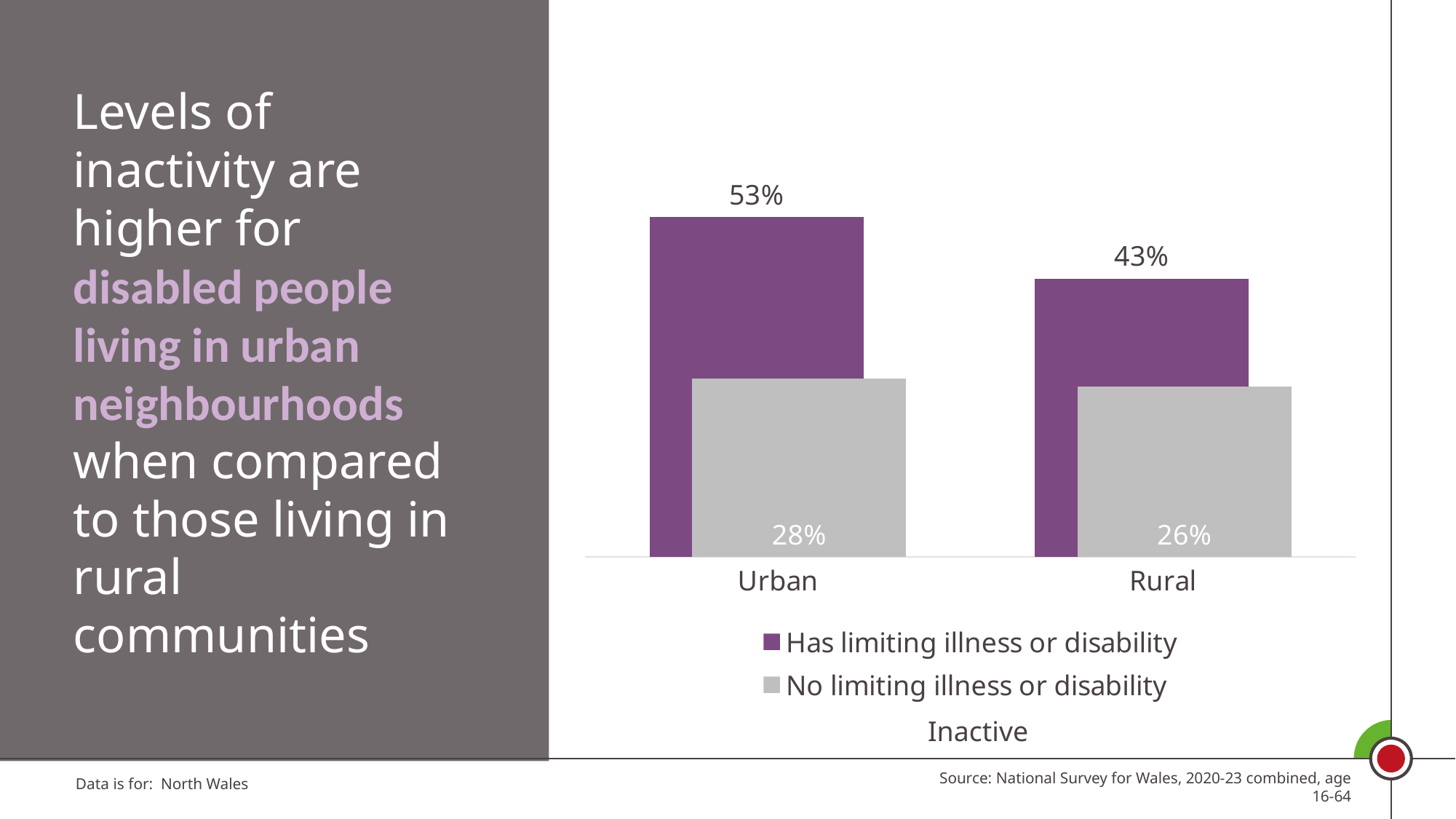
What is the difference between the Urban and Rural values for people with a limiting illness or disability? 10% What is the inactivity value for people with a limiting illness or disability in Rural areas? 43% What is the difference between the two Urban bars (limiting illness or disability vs no limiting illness or disability)? 25% What is the inactivity value for people with no limiting illness or disability in Urban areas? 28% How many series does the chart legend list? 2 Which bar shows the lowest inactivity value on the chart? No limiting illness or disability, Rural Is the inactivity value for people with a limiting illness or disability higher in Urban or Rural areas? Urban What is the inactivity value for people with a limiting illness or disability in Urban areas? 53% What is the inactivity value for people with no limiting illness or disability in Rural areas? 26% How many categories are shown on the x axis of the chart? 2 What type of chart is shown on the slide? Bar chart Which bar shows the highest inactivity value on the chart? Has limiting illness or disability, Urban